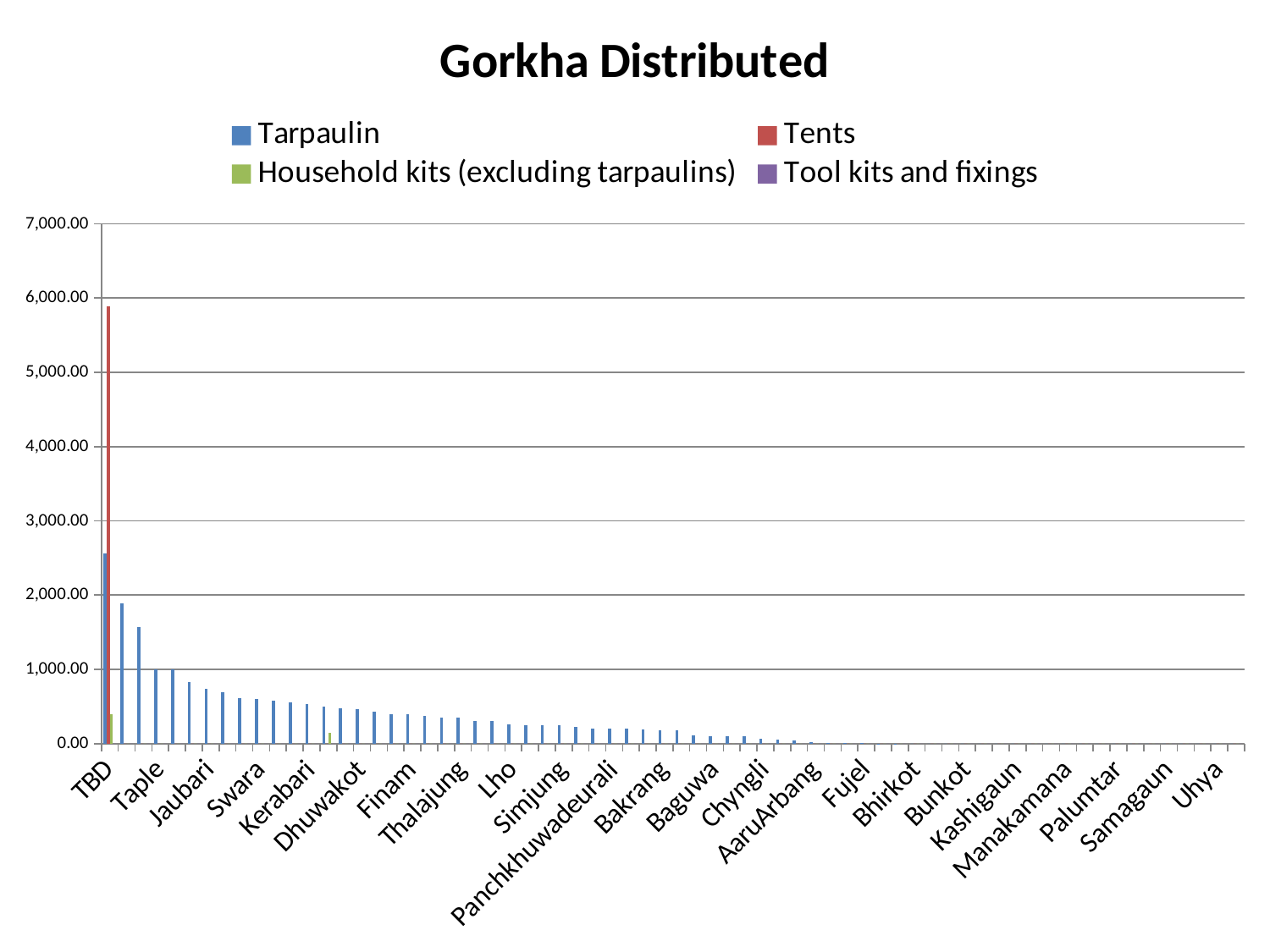
What type of chart is shown on the slide? bar chart Is the Tarpaulin value for Swara greater or less than 1,000.00? less Do the Tarpaulin values rise or fall moving from left to right along the x axis? fall Which series is shown in red in the legend? Tents What is the title of the chart? Gorkha Distributed For TBD, which is larger: the Tents value or the Tarpaulin value? Tents Which category has the tallest bar in the chart? TBD How many series does the legend list? 4 Is the Tarpaulin value for Lho greater or less than 1,000.00? less Is the Tents value for TBD greater or less than 5,000.00? greater